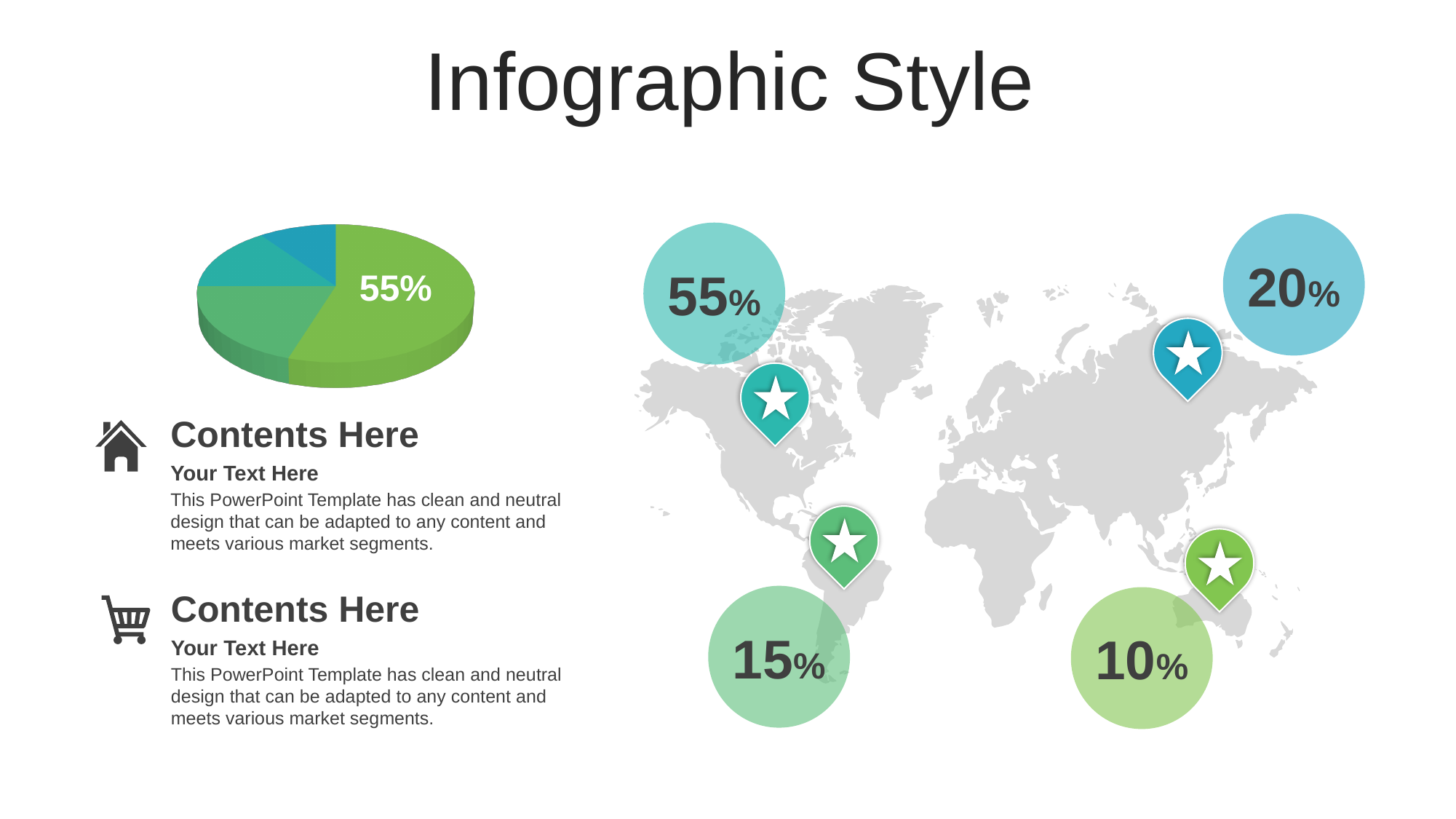
How many slices does the pie chart have? 4 What value is printed on the largest slice of the pie chart? 55% Which is larger, the green slice labelled 55% or the dark blue slice? The green slice labelled 55% What colour is the slice of the pie chart that carries the 55% label? Green What kind of chart is shown on the left of the slide? Pie chart Which slice of the pie chart is the largest? The green slice labelled 55% Does the labelled slice of the pie chart account for more or less than half of the pie? More What share of the pie does the labelled green slice represent? 55% Which slice of the pie chart is the smallest? The dark blue slice Does the pie chart have a legend? No